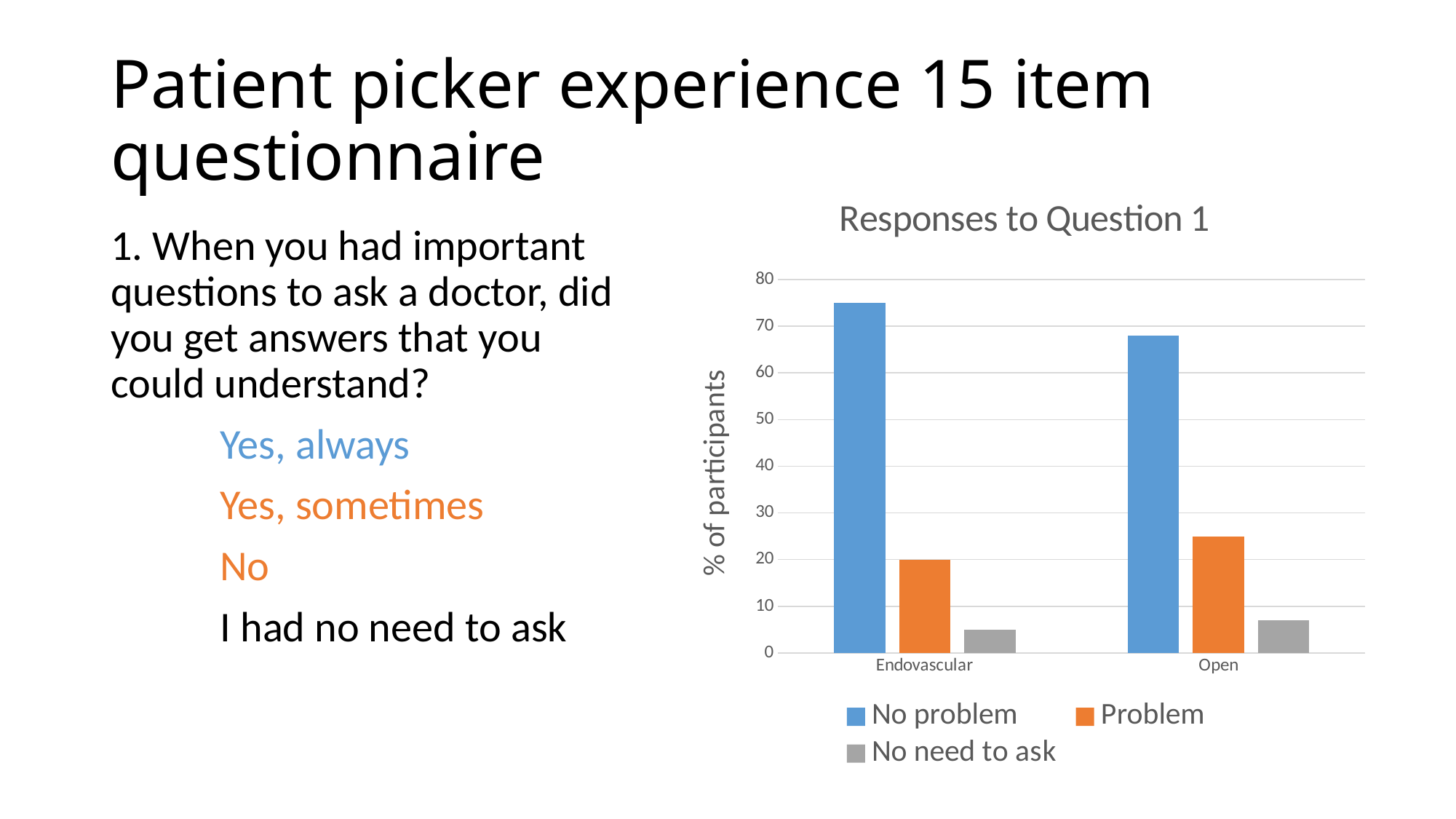
How many categories are shown on the x axis of the chart? 2 What is the label of the vertical axis of the chart? % of participants What is the title of the chart? Responses to Question 1 How many series does the chart legend list? 3 Which group has the larger value for No problem, Endovascular or Open? Endovascular Is the value for No problem in the Open group greater or less than 70? less Is the value for Problem in the Open group greater or less than 20? greater What kind of chart is shown on the slide? bar chart Which series has the lowest value in the Endovascular group? No need to ask Is the value for No problem in the Endovascular group greater or less than 70? greater Which group has the larger value for Problem, Endovascular or Open? Open